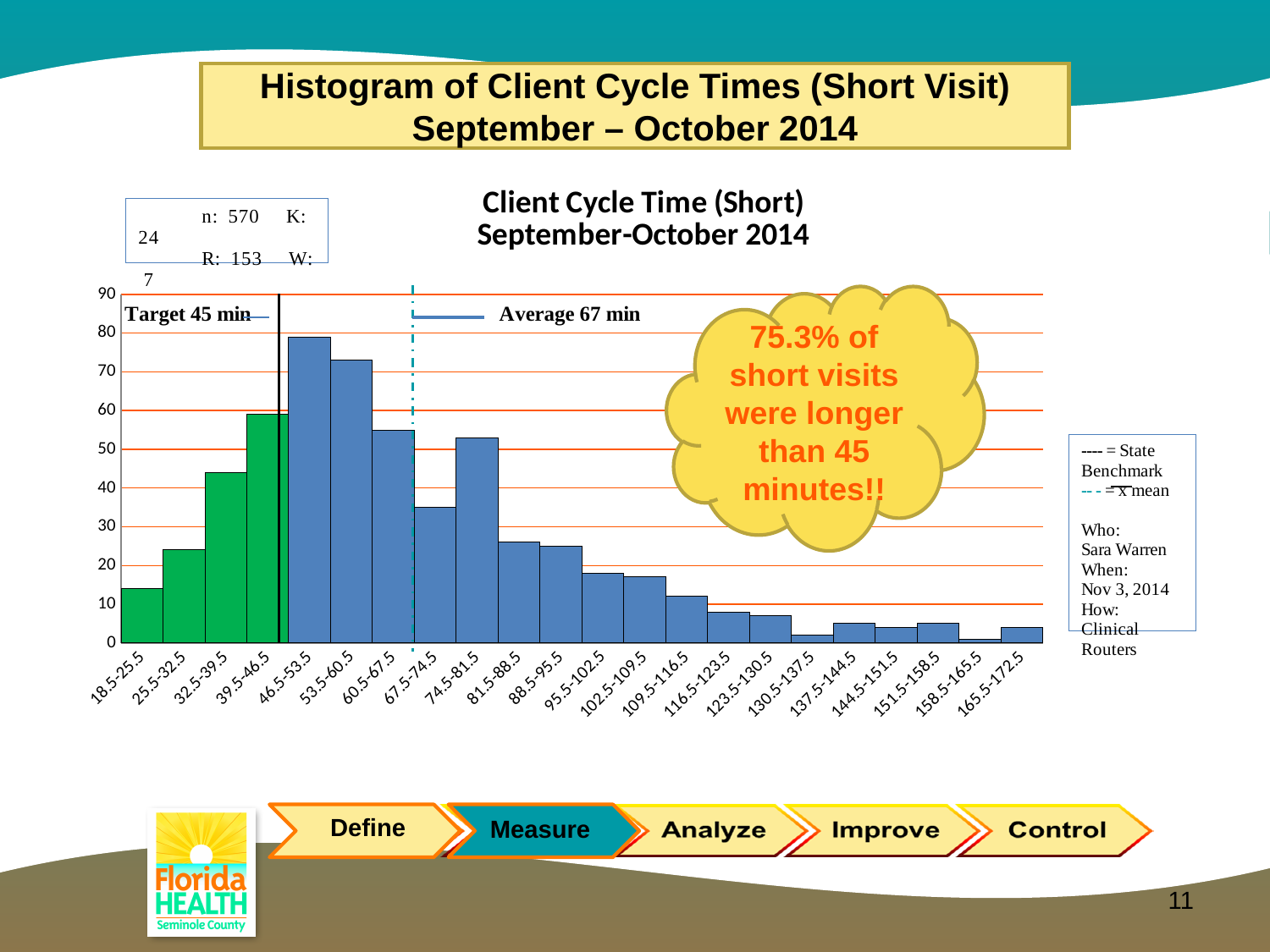
Is the count for the 53.5-60.5 bin greater or less than 60? greater Which cycle-time bin has the highest count in the histogram? 46.5-53.5 Is the count for the 18.5-25.5 bin greater or less than 20? less Which bin has the larger count, 67.5-74.5 or 74.5-81.5? 74.5-81.5 What kind of chart is shown on the slide? bar chart What average cycle time is labelled on the chart? Average 67 min Is the count for the 67.5-74.5 bin greater or less than 40? less Which bin has the larger count, 32.5-39.5 or 39.5-46.5? 39.5-46.5 Do the counts generally rise or fall along the x axis from the 46.5-53.5 bin to the 165.5-172.5 bin? fall How many cycle-time bins (categories) are shown on the x axis of the histogram? 22